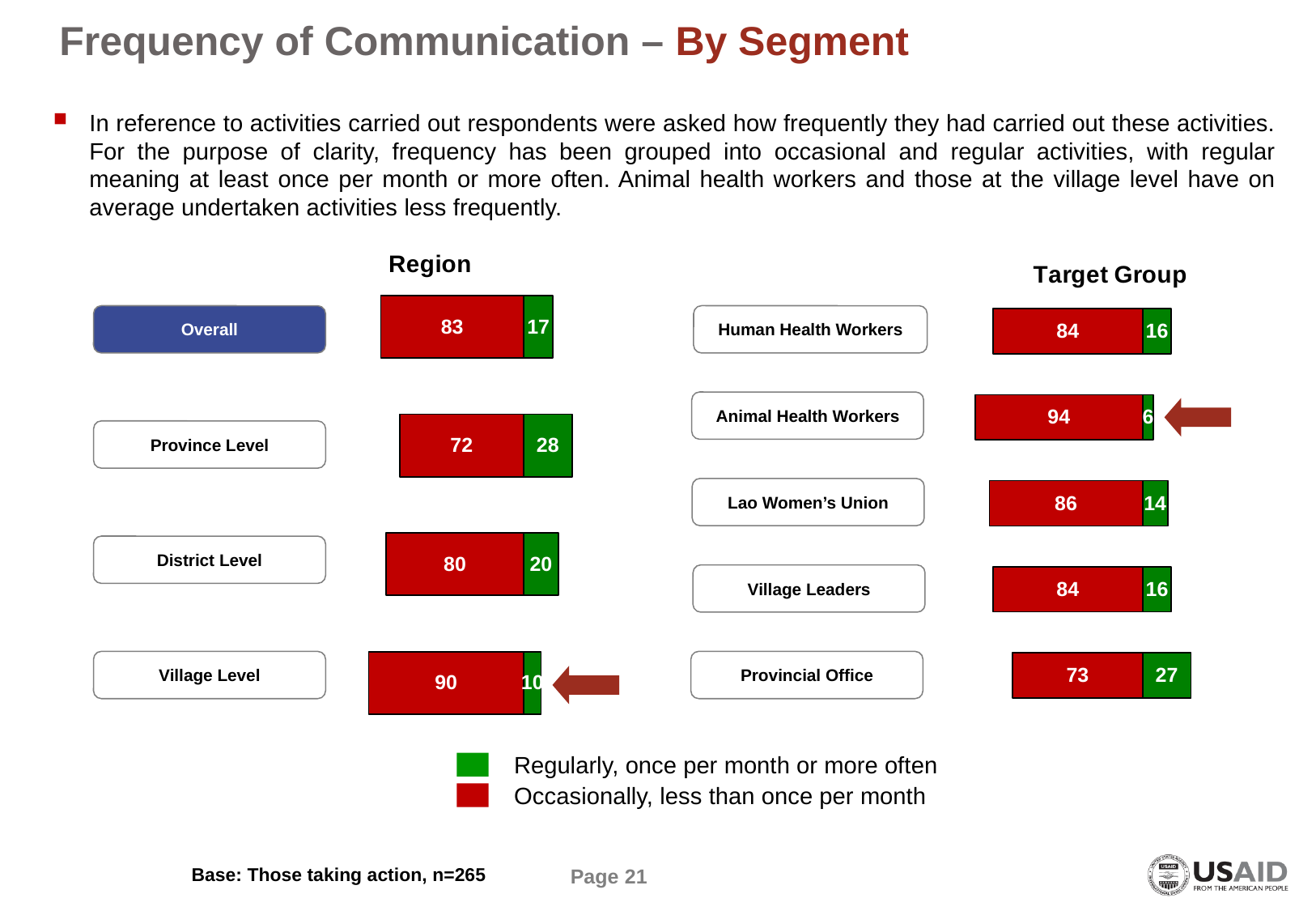
In the Target Group chart, what is the total of the stacked bar for Human Health Workers? 100 In the Target Group chart, what is the 'Regularly, once per month or more often' value for Provincial Office? 27 In the Target Group chart, which has a larger 'Regularly' value: Lao Women's Union or Provincial Office? Provincial Office In the Region chart, what is the 'Regularly, once per month or more often' value for Village Level? 10 How many series does the legend list? 2 In the Target Group chart, which category has the lowest 'Regularly, once per month or more often' value? Animal Health Workers How many categories are shown in the Target Group chart? 5 In the Region chart, what is the 'Occasionally, less than once per month' value for Province Level? 72 In the Region chart, what is the difference between the 'Occasionally' values for Village Level and Province Level? 18 What kind of chart is the Region chart? Stacked bar chart In the Region chart, which category has the highest 'Regularly, once per month or more often' value? Province Level In the Target Group chart, what is the 'Occasionally, less than once per month' value for Animal Health Workers? 94